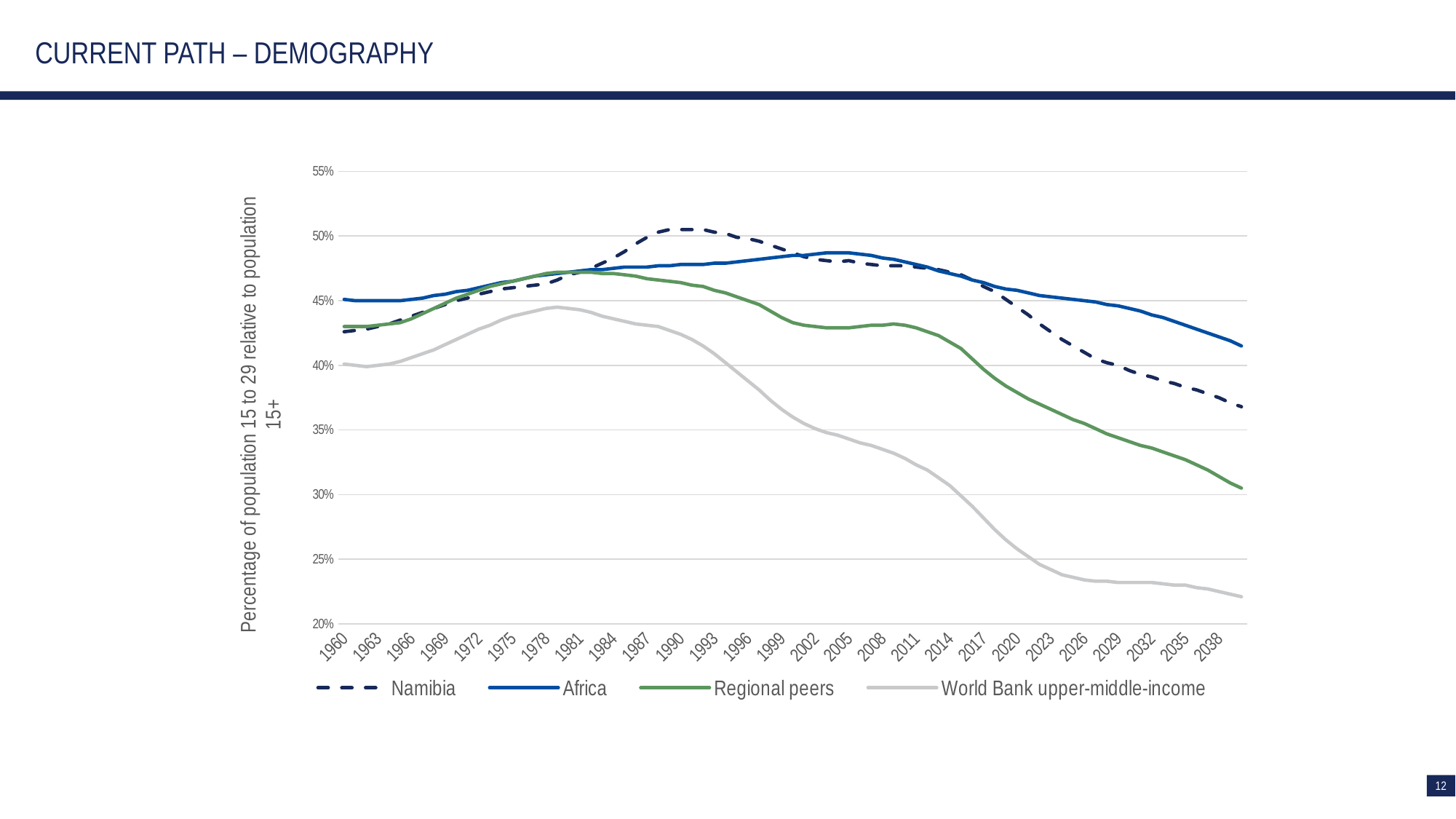
At 2038, which is larger: the value for Namibia or the value for Regional peers? Namibia Which series has the highest value at 2038? Africa How many series does the legend list? 4 Is the value for Namibia at 1990 greater or less than 45%? greater What kind of chart is shown on the slide? line chart Is the value for Africa at 2038 greater or less than 40%? greater Is the value for World Bank upper-middle-income at 2038 greater or less than 25%? less Which series has the lowest value at 1960? World Bank upper-middle-income Does the World Bank upper-middle-income series rise or fall from 1981 to 2038? fall What is the label on the vertical axis of the chart? Percentage of population 15 to 29 relative to population 15+ Which series has the lowest value at 2038? World Bank upper-middle-income